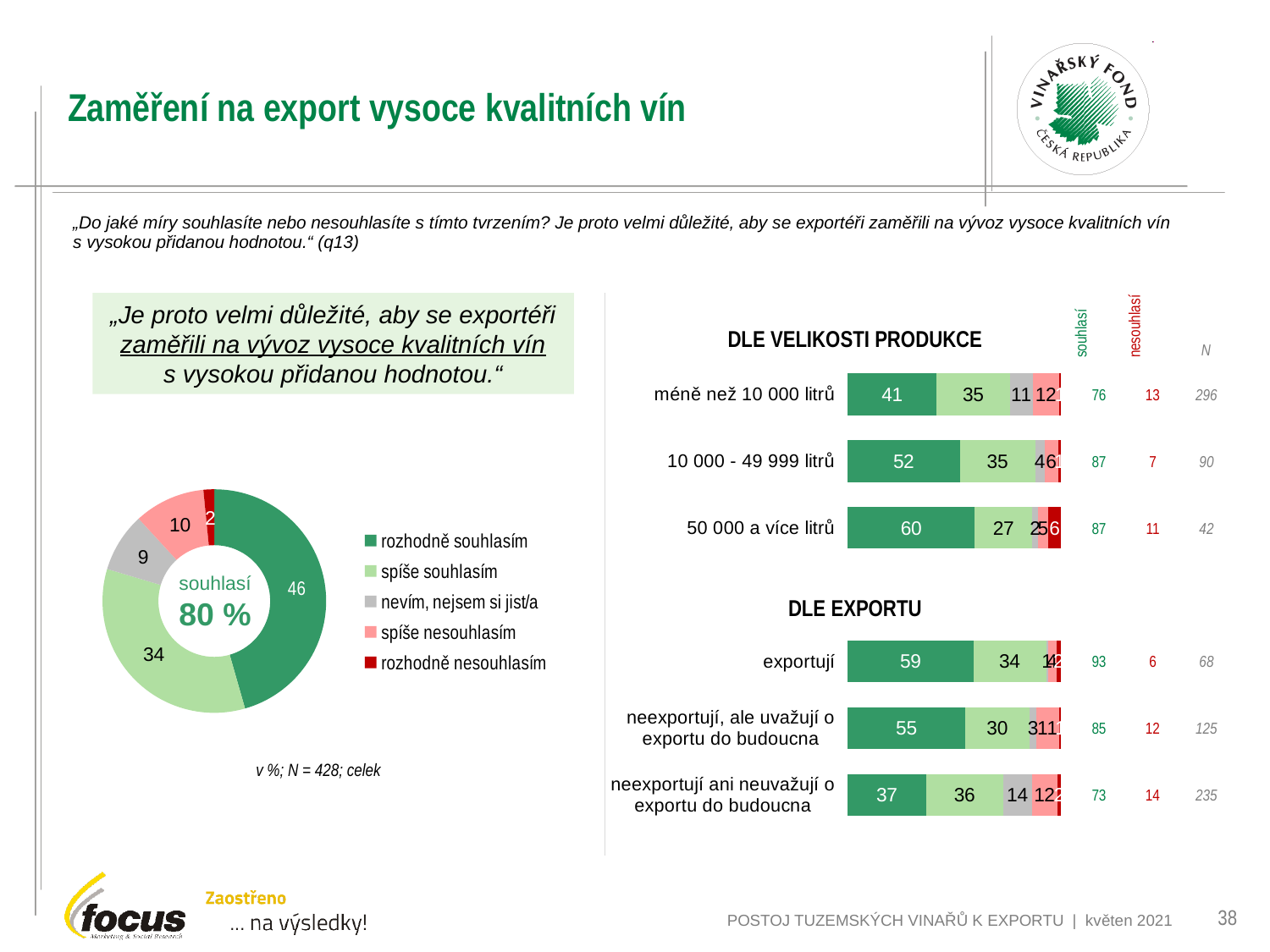
How many entries does the legend of the donut chart on the left list? 5 In the "DLE VELIKOSTI PRODUKCE" chart, which production-size category has the lowest "rozhodně souhlasím" value? méně než 10 000 litrů In the "DLE EXPORTU" chart, what is the "rozhodně souhlasím" value for "exportují"? 59 In the donut chart on the left, what percentage of respondents answered "rozhodně souhlasím"? 46 In the donut chart on the left, what percentage of respondents answered "spíše souhlasím"? 34 In the "DLE EXPORTU" chart, which group has the highest "souhlasí" total? exportují In the "DLE VELIKOSTI PRODUKCE" chart, what is the difference between the "rozhodně souhlasím" values for "50 000 a více litrů" and "méně než 10 000 litrů"? 19 In the donut chart on the left, which response category has the smallest share? rozhodně nesouhlasím In the "DLE VELIKOSTI PRODUKCE" chart, what is the "rozhodně souhlasím" value for "50 000 a více litrů"? 60 In the donut chart on the left, what total share of respondents agree ("souhlasí"), as shown in the centre of the chart? 80 % How many categories (bars) does the "DLE EXPORTU" chart show? 3 What type of chart is shown on the left of the slide? Donut (pie) chart